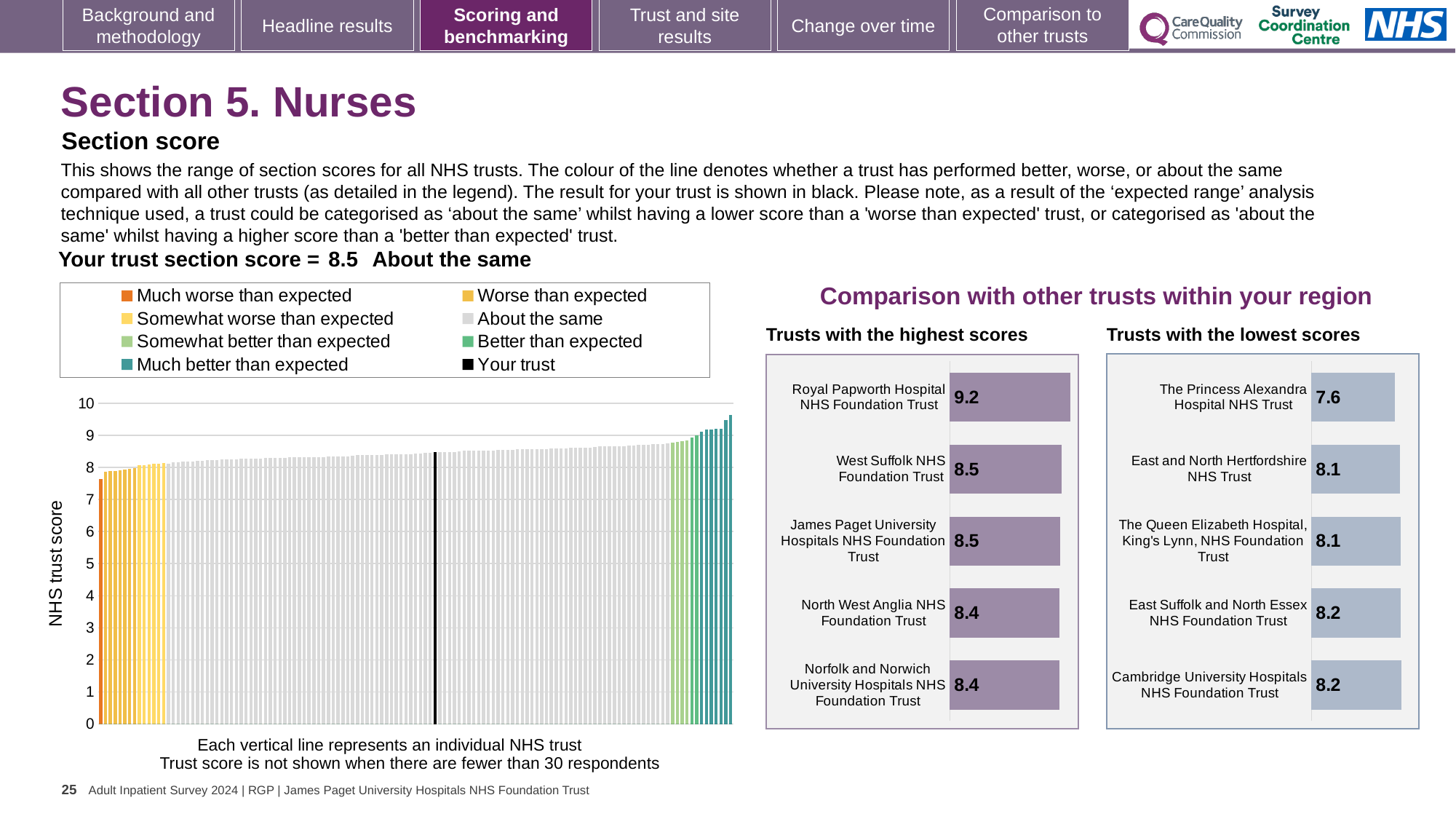
How many trusts are shown in the 'Trusts with the highest scores' chart? 5 In the 'Trusts with the lowest scores' chart, what is the score for The Princess Alexandra Hospital NHS Trust? 7.6 In the 'Trusts with the highest scores' chart, what is the difference between the scores of Royal Papworth Hospital NHS Foundation Trust and West Suffolk NHS Foundation Trust? 0.7 Which is larger: the score for James Paget University Hospitals NHS Foundation Trust in the 'Trusts with the highest scores' chart, or the score for East and North Hertfordshire NHS Trust in the 'Trusts with the lowest scores' chart? James Paget University Hospitals NHS Foundation Trust In the 'Trusts with the lowest scores' chart, what is the score for Cambridge University Hospitals NHS Foundation Trust? 8.2 In the 'Trusts with the highest scores' chart, what is the score for Royal Papworth Hospital NHS Foundation Trust? 9.2 In the 'Trusts with the lowest scores' chart, which trust has the lowest score? The Princess Alexandra Hospital NHS Trust How many entries does the legend of the main 'NHS trust score' chart list? 8 In the 'Trusts with the highest scores' chart, which trust has the highest score? Royal Papworth Hospital NHS Foundation Trust In the 'Trusts with the lowest scores' chart, what is the difference between the scores of East Suffolk and North Essex NHS Foundation Trust and The Princess Alexandra Hospital NHS Trust? 0.6 In the 'Trusts with the highest scores' chart, what is the score for North West Anglia NHS Foundation Trust? 8.4 What type of chart is the 'Trusts with the lowest scores' chart? Bar chart